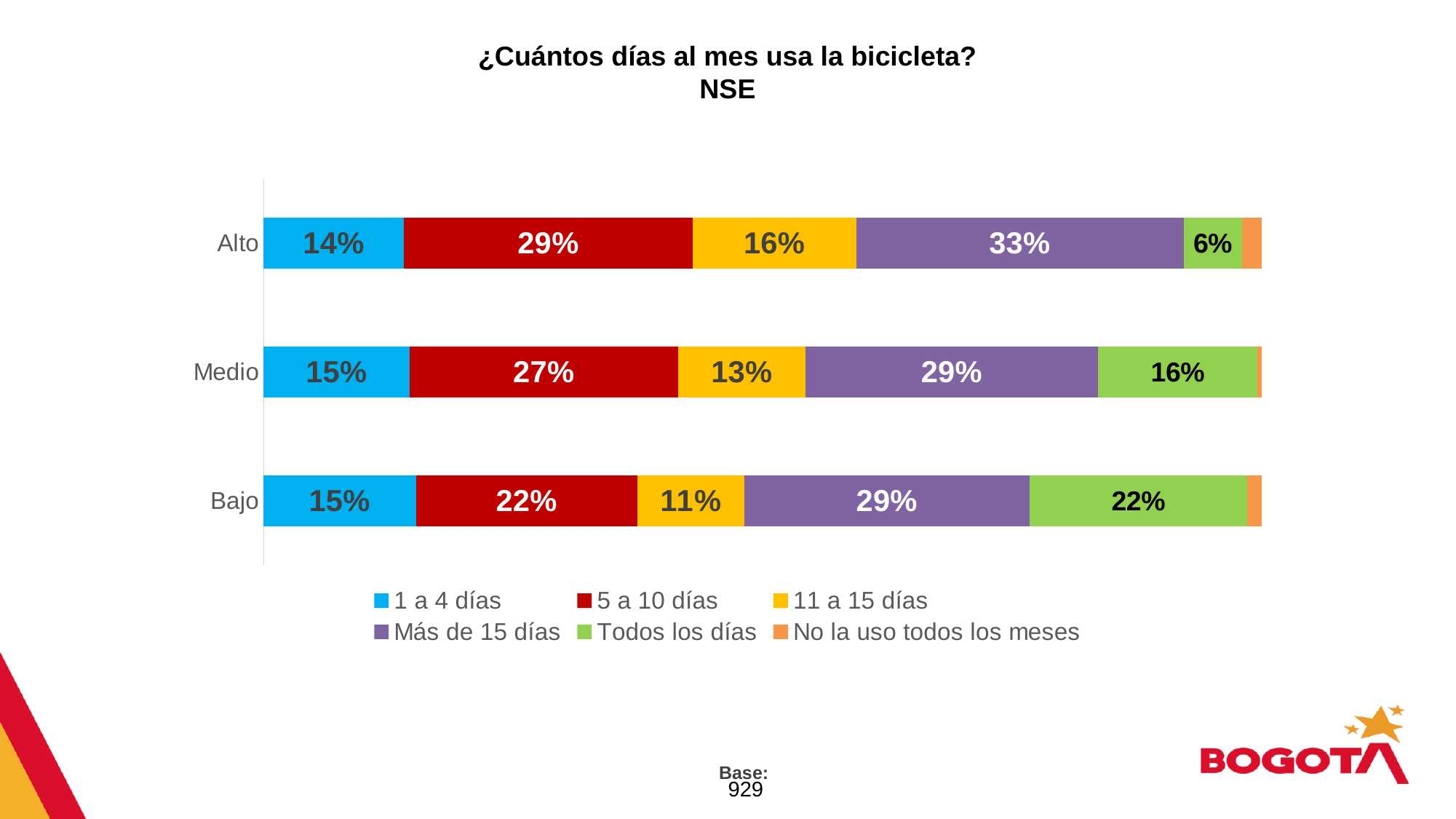
What is the value for 'Todos los días' in the Bajo category? 22% Which is larger: the 'Todos los días' value for Alto or for Medio? Medio Which category has the lowest value for '11 a 15 días'? Bajo What kind of chart is shown on the slide? Stacked bar chart How many series does the legend list? 6 What is the title of the chart? ¿Cuántos días al mes usa la bicicleta? NSE What is the difference between the 'Todos los días' values for Bajo and Alto? 16 percentage points How many NSE categories are plotted on the chart? 3 What is the value for 'Más de 15 días' in the Alto category? 33% What is the value for '5 a 10 días' in the Medio category? 27% What is the difference between the '5 a 10 días' values for Alto and Bajo? 7 percentage points Which category has the highest value for 'Todos los días'? Bajo